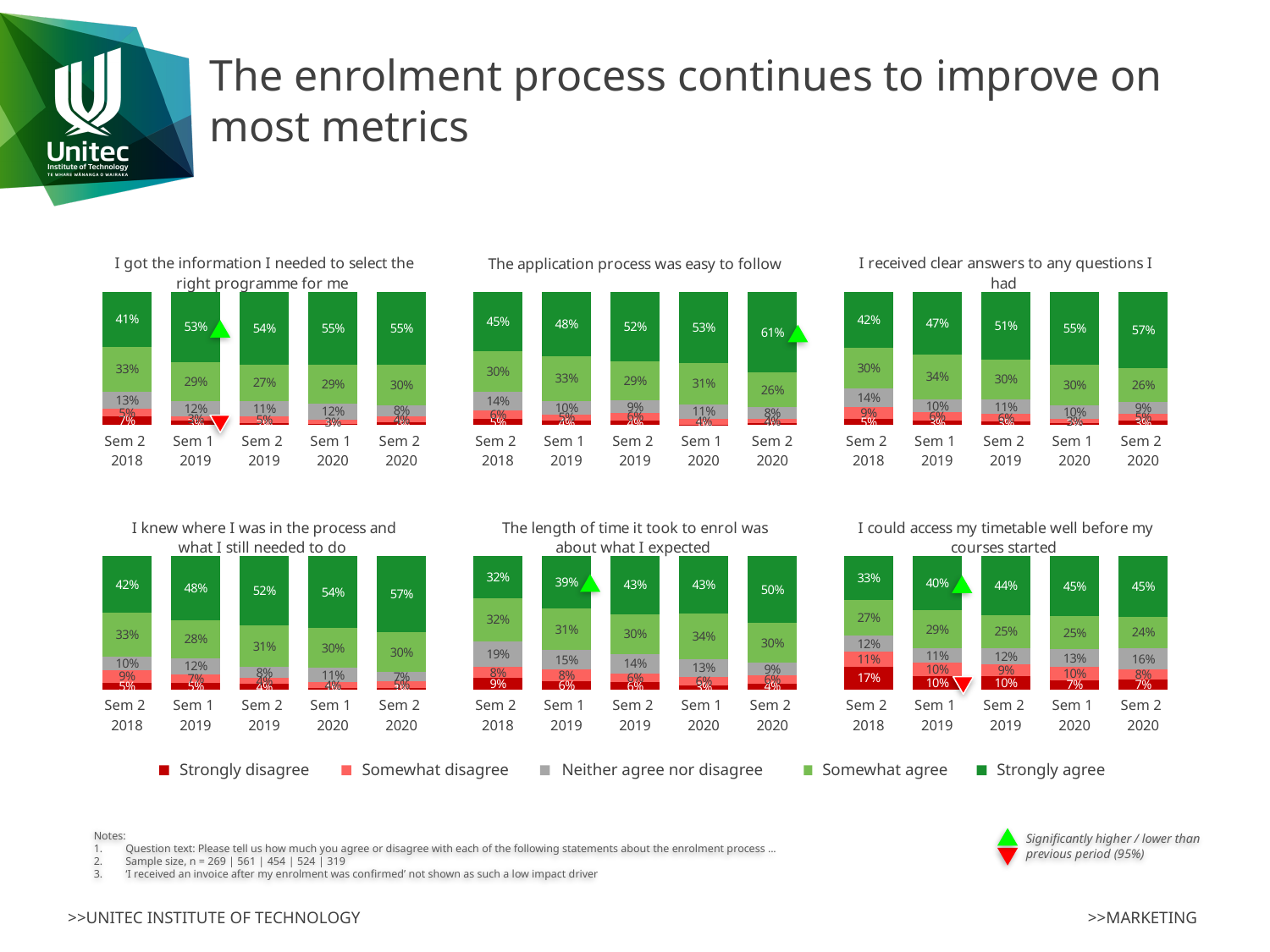
In the chart 'The application process was easy to follow', what is the Strongly agree value for Sem 2 2020? 61% In the chart 'I got the information I needed to select the right programme for me', what is the Somewhat agree value for Sem 2 2018? 33% In the chart 'I received clear answers to any questions I had', which period has the highest Strongly agree value? Sem 2 2020 In the chart 'I knew where I was in the process and what I still needed to do', does the Strongly agree value rise or fall from Sem 2 2018 to Sem 2 2020? Rise In the chart 'I could access my timetable well before my courses started', what is the Strongly disagree value for Sem 2 2018? 17% In the chart 'The application process was easy to follow', is the Somewhat agree value larger for Sem 1 2019 or Sem 2 2020? Sem 1 2019 In the chart 'I knew where I was in the process and what I still needed to do', what is the difference between the Strongly agree values for Sem 2 2020 and Sem 2 2018? 15% In the chart 'The length of time it took to enrol was about what I expected', which period has the lowest Strongly agree value? Sem 2 2018 What kind of chart is 'I received clear answers to any questions I had'? Stacked bar chart Which legend entry is shown in dark green? Strongly agree How many series does the legend list? 5 How many periods are shown on the x axis of the chart 'I could access my timetable well before my courses started'? 5